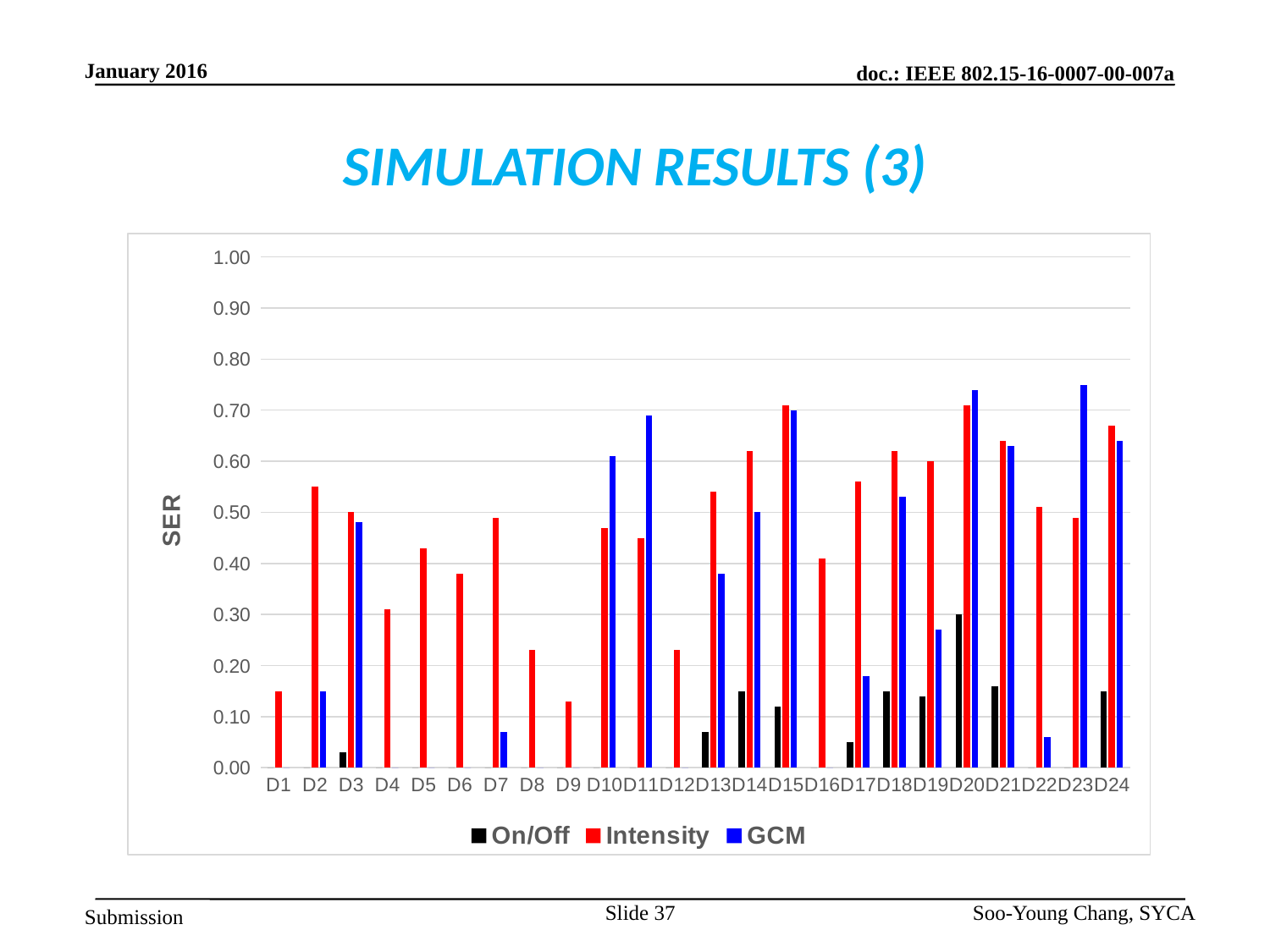
Is the Intensity value for D4 greater or less than 0.40? less Is the Intensity value for D2 greater or less than 0.50? greater Is the On/Off value for D20 greater or less than 0.20? greater Which category has the highest On/Off value? D20 How many series does the legend list? 3 What kind of chart is shown on the slide? bar chart Which is larger, the Intensity value for D2 or the Intensity value for D4? D2 Which is larger at D18, the Intensity value or the GCM value? Intensity How many categories are shown on the x axis? 24 What is the label on the y axis? SER